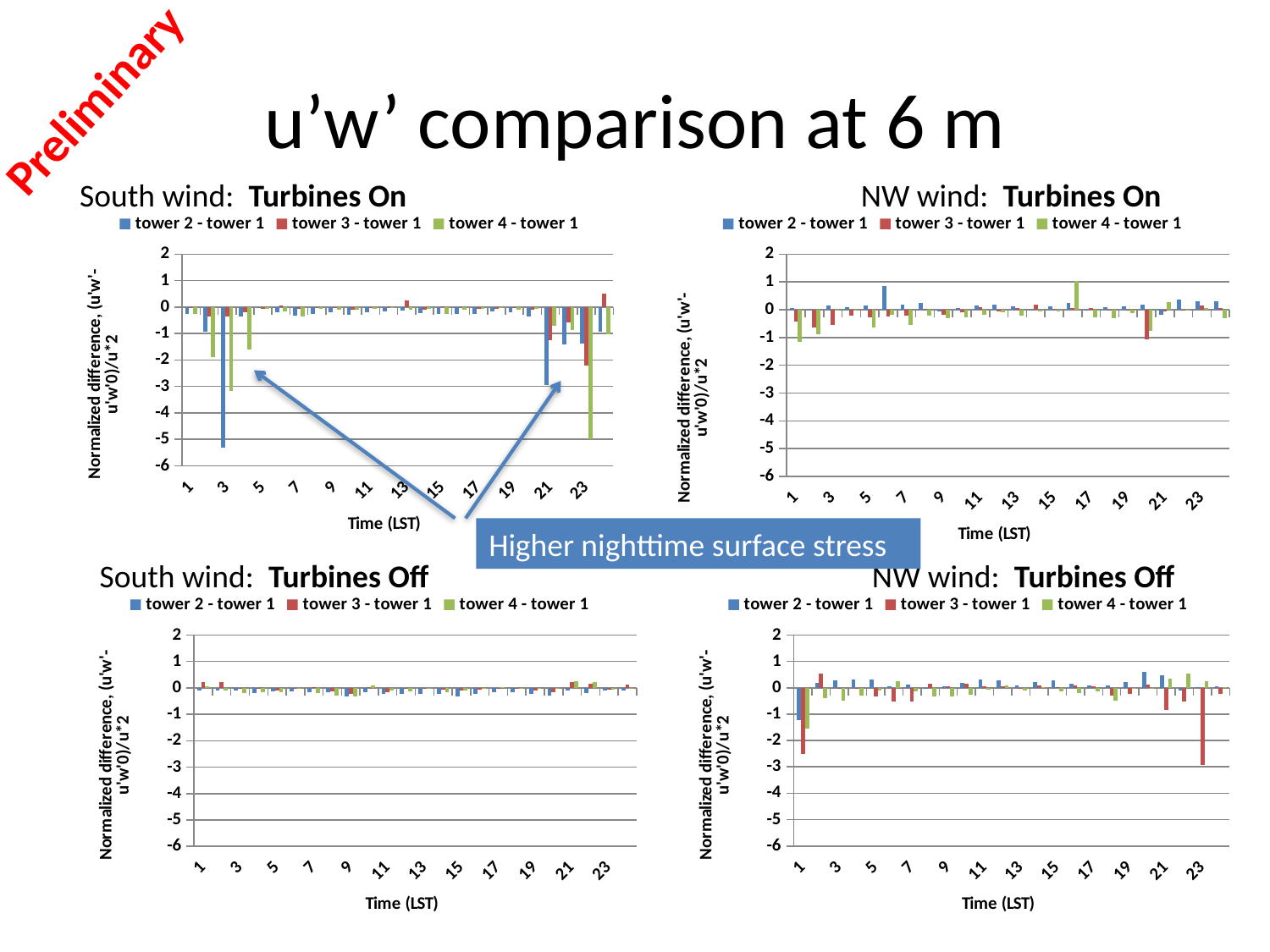
In the 'NW wind: Turbines Off' chart, is the value for tower 2 - tower 1 at hour 1 greater or less than 0? less What is the x-axis title of the 'NW wind: Turbines On' chart? Time (LST) In the 'South wind: Turbines On' chart, is the value for tower 4 - tower 1 at hour 3 greater or less than -2? less In the 'NW wind: Turbines On' chart, is the value for tower 4 - tower 1 at hour 16 greater or less than 0? greater In the 'South wind: Turbines On' chart, which series has the lowest bar on the chart? tower 2 - tower 1 What kind of chart is the 'South wind: Turbines On' chart? bar chart How many series does the legend of the 'NW wind: Turbines Off' chart list? 3 In the 'NW wind: Turbines Off' chart, which series has the lowest bar on the chart? tower 3 - tower 1 What is the highest value shown on the y axis of the 'South wind: Turbines Off' chart? 2 In the 'South wind: Turbines On' chart, which series has the lower value at hour 3, tower 2 - tower 1 or tower 4 - tower 1? tower 2 - tower 1